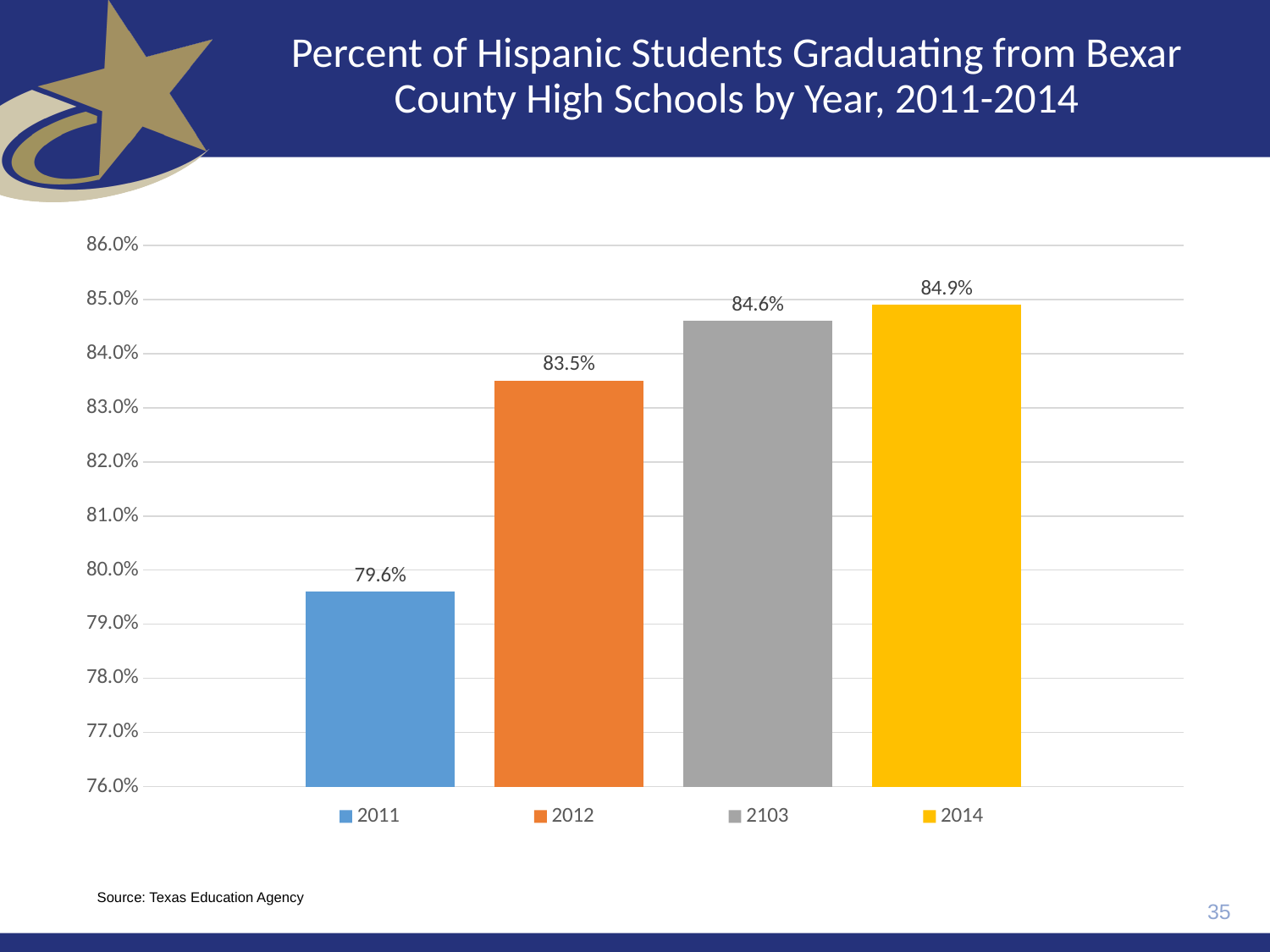
What is the graduation percentage for 2014? 84.9% What is the graduation percentage for 2011? 79.6% How many bars are shown in the chart? 4 Which year has the lowest graduation percentage? 2011 What is the graduation percentage for the bar labelled 2103 in the legend? 84.6% What is the difference between the 2012 and 2011 graduation percentages? 3.9% Do the graduation percentages rise or fall from 2011 to 2014? Rise Which year has the highest graduation percentage? 2014 What is the graduation percentage for 2012? 83.5% Which is larger, the value for 2011 or the value for 2012? 2012 What kind of chart is shown on the slide? Bar chart What is the difference between the 2014 and 2011 graduation percentages? 5.3%